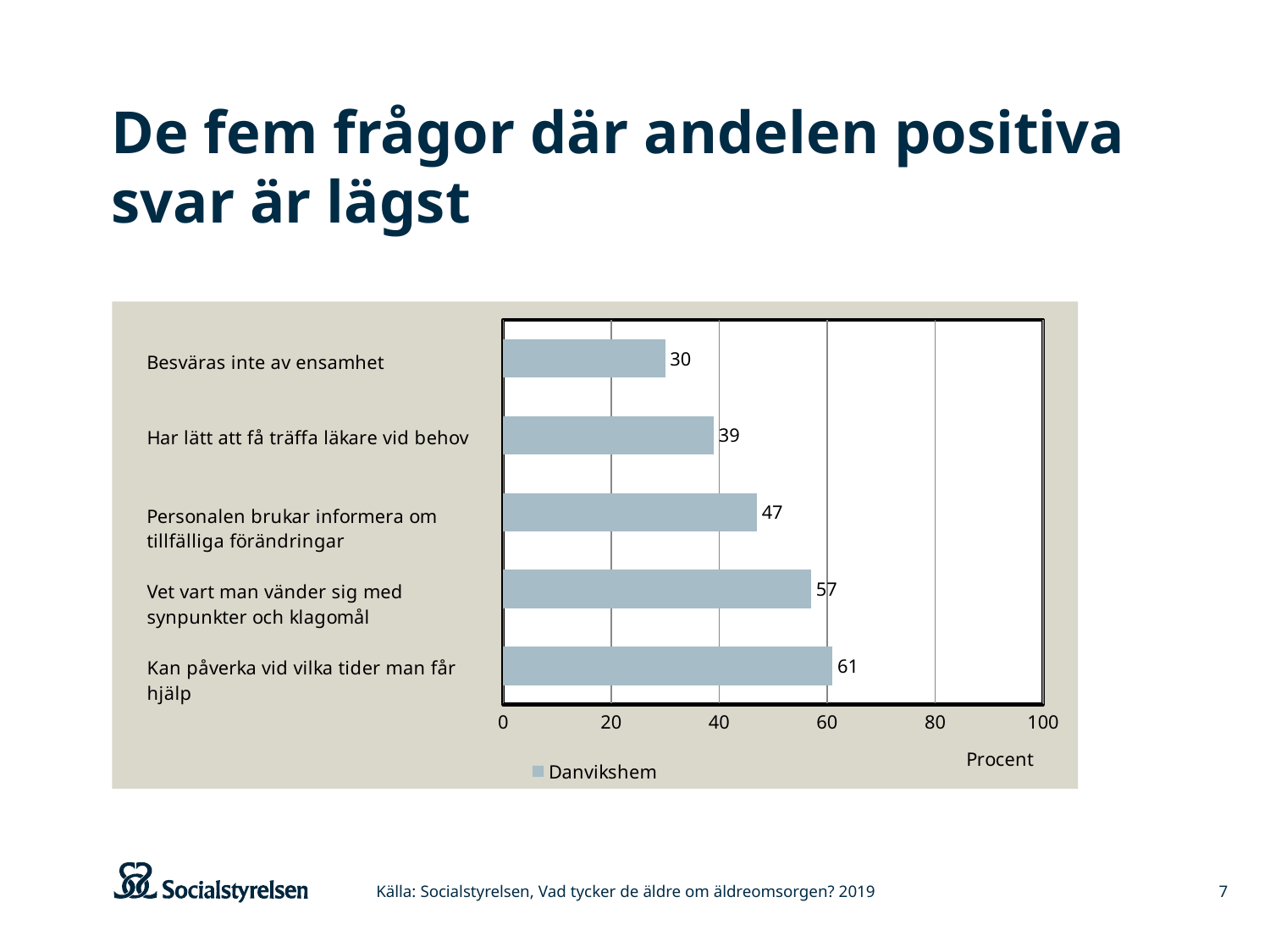
What kind of chart is shown on the slide? bar chart Which category has the lowest value? Besväras inte av ensamhet What is the difference between the values for "Kan påverka vid vilka tider man får hjälp" and "Besväras inte av ensamhet"? 31 What is the value for "Besväras inte av ensamhet"? 30 What is the value for "Har lätt att få träffa läkare vid behov"? 39 What is the value for "Personalen brukar informera om tillfälliga förändringar"? 47 Which category has the highest value? Kan påverka vid vilka tider man får hjälp Which is larger: the value for "Har lätt att få träffa läkare vid behov" or the value for "Vet vart man vänder sig med synpunkter och klagomål"? Vet vart man vänder sig med synpunkter och klagomål Is the value for "Vet vart man vänder sig med synpunkter och klagomål" greater or less than 40? greater How many categories are shown in the chart? 5 What is the value for "Kan påverka vid vilka tider man får hjälp"? 61 What series name does the legend show? Danvikshem